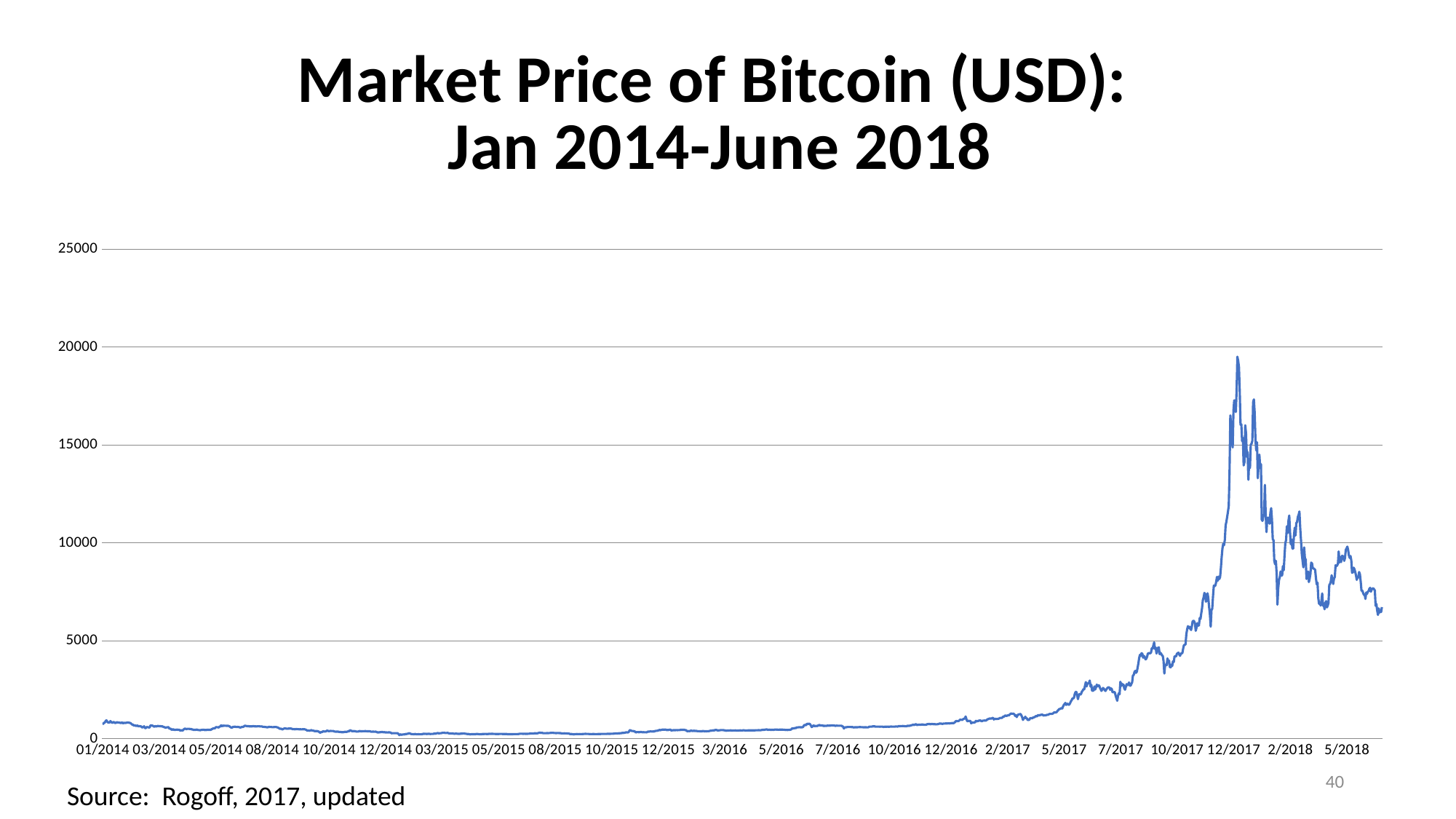
Around which x-axis label does the line reach its highest point? 12/2017 Which is larger, the value at 5/2018 or the value at 5/2016? 5/2018 Is the value at 5/2016 greater or less than 5000? less What is the title of the chart? Market Price of Bitcoin (USD): Jan 2014-June 2018 Does the line rise or fall between 5/2017 and 12/2017? rise How many lines are plotted on the chart? 1 What source is cited below the chart? Rogoff, 2017, updated Is the value at 5/2018 greater or less than 5000? greater What kind of chart is shown on the slide? line chart Is the highest value reached by the line greater or less than 15000? greater Does the line rise or fall overall between 12/2017 and 5/2018? fall